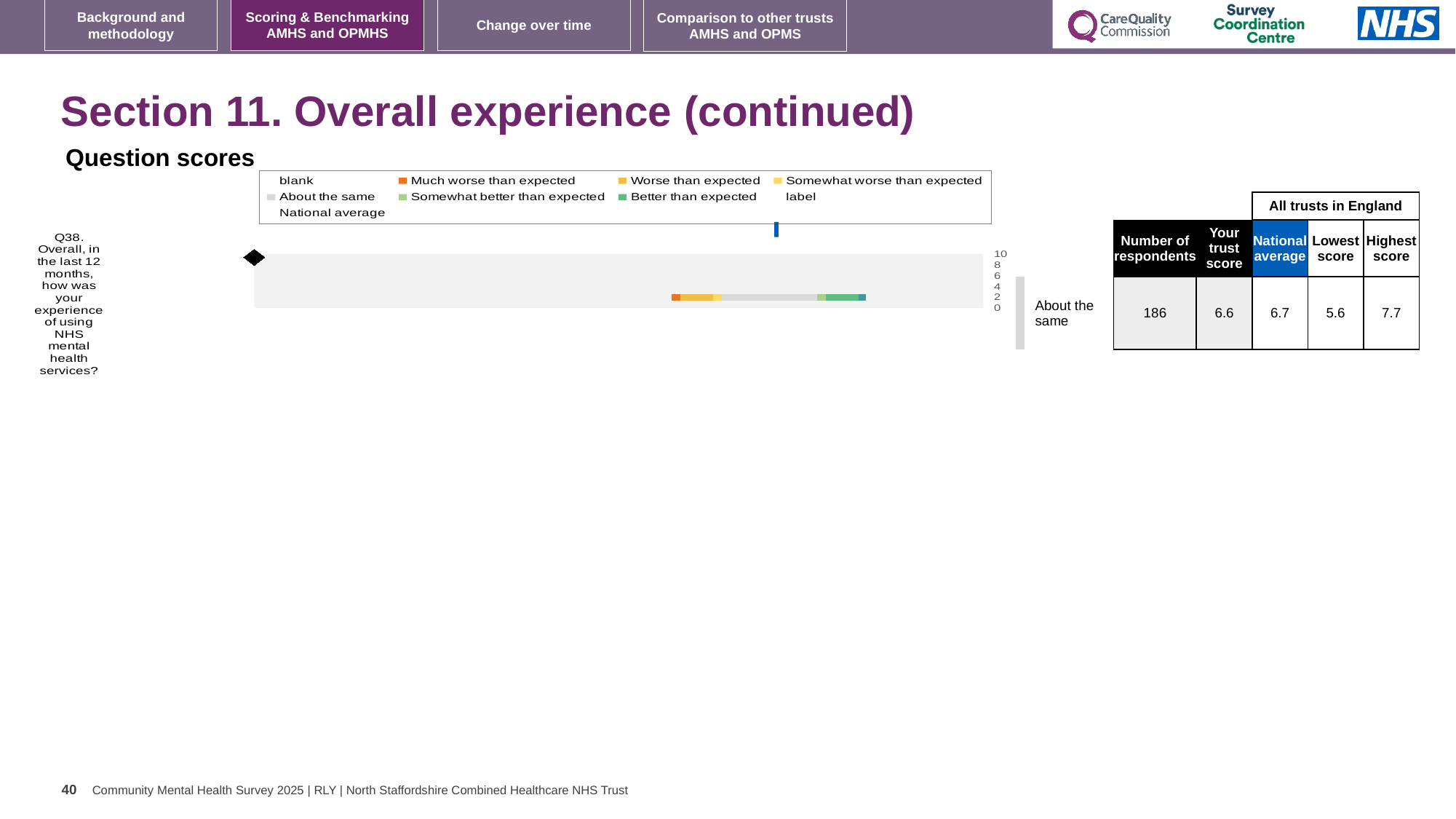
For Q38, what is the difference between the National average and the trust score? 0.1 How many survey questions are plotted in the Question scores chart? 1 In the table beside the chart, what is the 'Your trust score' for Q38? 6.6 In the table beside the chart, how many respondents answered Q38? 186 What kind of chart is used to show the Q38 question score? bar chart Which legend entry in the Question scores chart is shown in orange? Much worse than expected In the table beside the chart, what is the National average for Q38? 6.7 What comparison label is shown next to the Q38 bar in the Question scores chart? About the same For Q38, which is larger: the trust score or the National average? National average For Q38, what is the difference between the Highest score and the Lowest score among all trusts in England? 2.1 In the table beside the chart, what is the Highest score among all trusts in England for Q38? 7.7 In the table beside the chart, what is the Lowest score among all trusts in England for Q38? 5.6